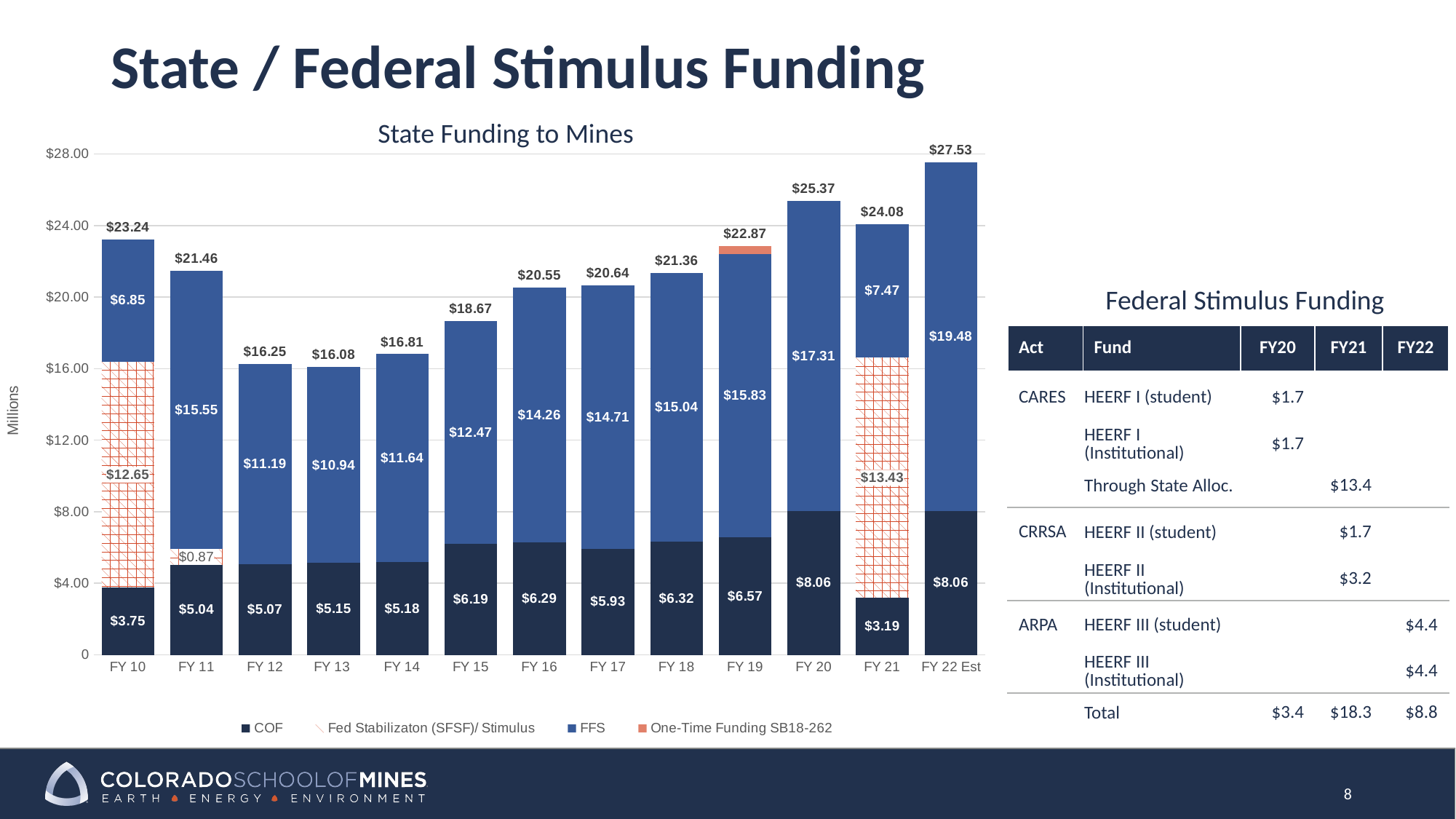
Which fiscal year has the lowest total state funding in the chart? FY 13 What is the total state funding to Mines shown for FY 22 Est? $27.53 What is the COF value for FY 21 in the State Funding to Mines chart? $3.19 What is the difference between the total state funding for FY 22 Est and FY 21? $3.45 Which is larger, the FFS value for FY 11 or the FFS value for FY 12? FY 11 Which fiscal year has the highest total state funding in the chart? FY 22 Est How many series does the legend of the State Funding to Mines chart list? 4 How many fiscal years are shown on the x axis of the State Funding to Mines chart? 13 What is the Fed Stabilization (SFSF)/Stimulus value for FY 10? $12.65 What is the FFS value for FY 20 in the State Funding to Mines chart? $17.31 Which series in the State Funding to Mines chart is shown in orange? One-Time Funding SB18-262 What kind of chart is the State Funding to Mines chart? Stacked bar chart